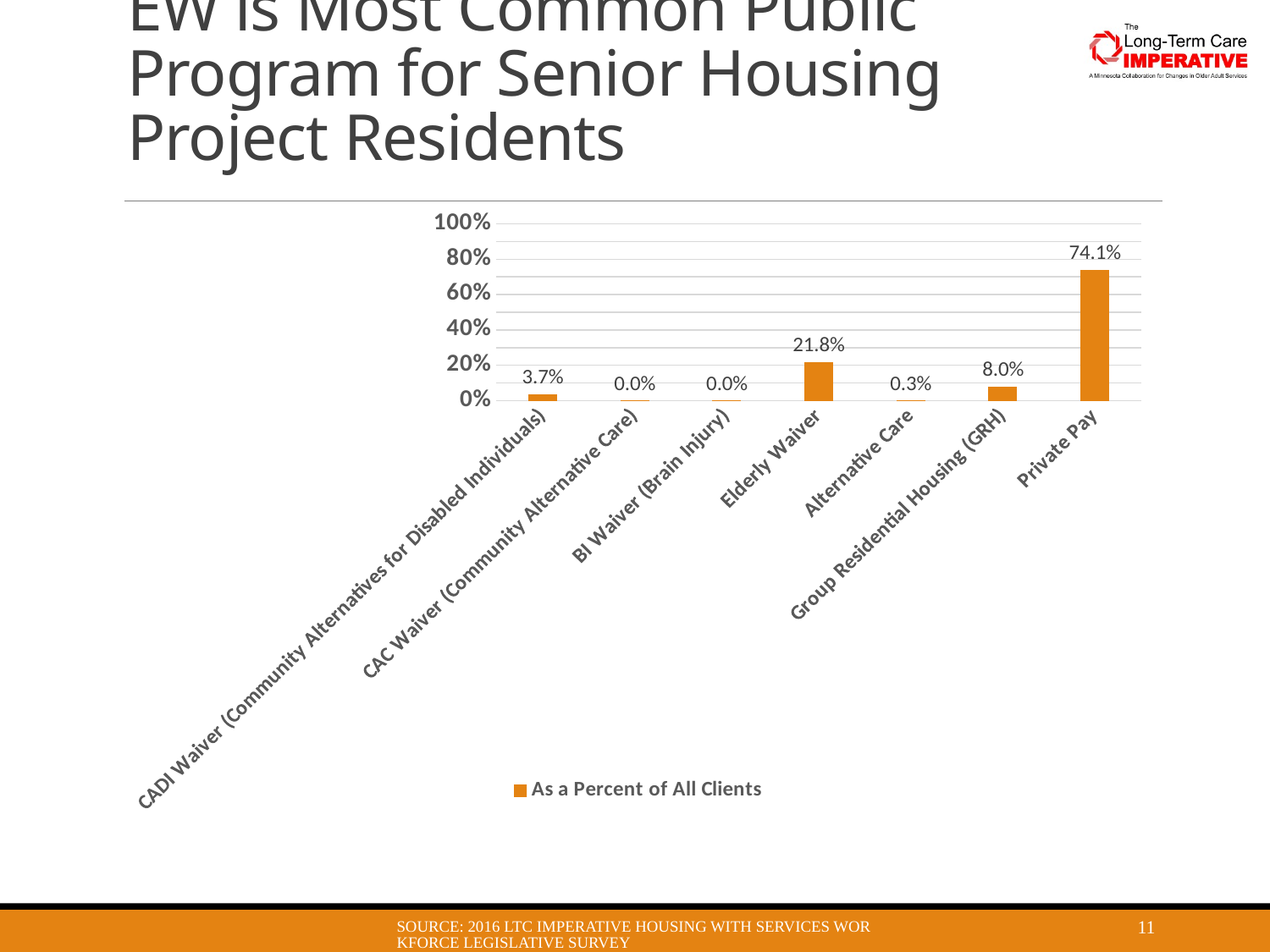
What is the value for Private Pay? 74.1% How many categories are shown on the x axis? 7 What is the difference between the values for Private Pay and Elderly Waiver? 52.3% What series name does the legend show? As a Percent of All Clients What is the value for Alternative Care? 0.3% What is the value for CADI Waiver (Community Alternatives for Disabled Individuals)? 3.7% Is the value for Private Pay greater or less than 60%? greater Which category has the highest value? Private Pay What kind of chart is shown on the slide? bar chart Which is larger, the value for Elderly Waiver or the value for Group Residential Housing (GRH)? Elderly Waiver What is the value for Group Residential Housing (GRH)? 8.0% What is the value for Elderly Waiver? 21.8%